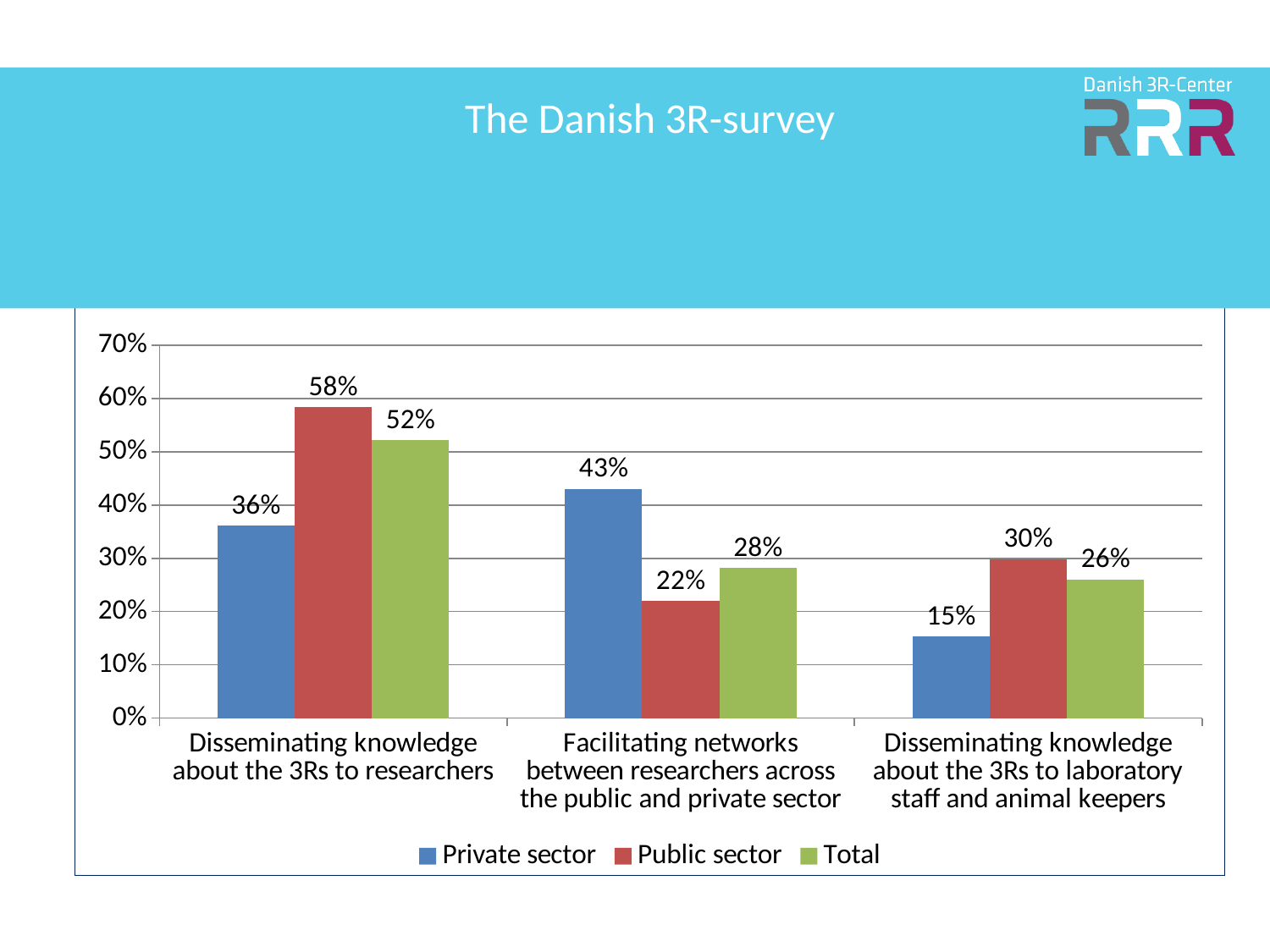
What is the Public sector value for 'Facilitating networks between researchers across the public and private sector'? 22% Which category has the lowest Private sector value? Disseminating knowledge about the 3Rs to laboratory staff and animal keepers Which category has the highest Public sector value? Disseminating knowledge about the 3Rs to researchers What kind of chart is shown on the slide? Bar chart How many categories are shown on the x axis? 3 What is the Private sector value for 'Disseminating knowledge about the 3Rs to researchers'? 36% How many series does the legend list? 3 For 'Facilitating networks between researchers across the public and private sector', which is larger: the Private sector value or the Public sector value? Private sector What is the Total value for 'Disseminating knowledge about the 3Rs to laboratory staff and animal keepers'? 26% Which colour represents the Total series in the legend? Green Is the Total value for 'Disseminating knowledge about the 3Rs to researchers' greater or less than 50%? greater What is the difference between the Public sector and Private sector values for 'Disseminating knowledge about the 3Rs to researchers'? 22%